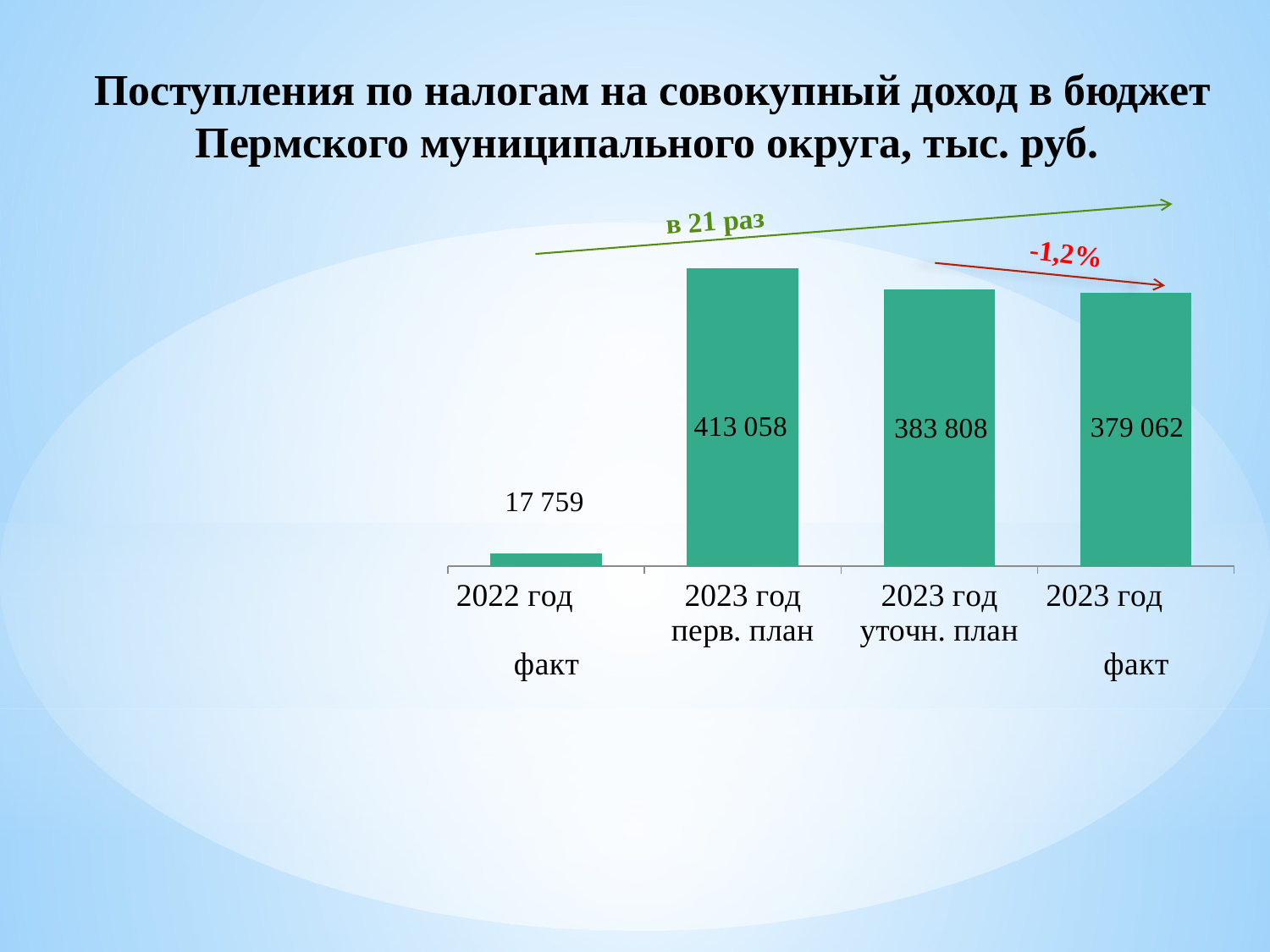
What is the value for 2023 год перв. план? 413 058 What is the value for 2022 год факт? 17 759 How many bars are shown in the chart? 4 Which is larger, the value for 2023 год уточн. план or 2023 год факт? 2023 год уточн. план What is the difference between 2023 год перв. план and 2023 год уточн. план? 29 250 What percentage change is shown by the red arrow annotation? -1,2% Which category has the highest value? 2023 год перв. план What is the value for 2023 год уточн. план? 383 808 Which category has the lowest value? 2022 год факт What is the difference between 2023 год уточн. план and 2023 год факт? 4 746 What kind of chart is shown on the slide? Bar chart What is the value for 2023 год факт? 379 062